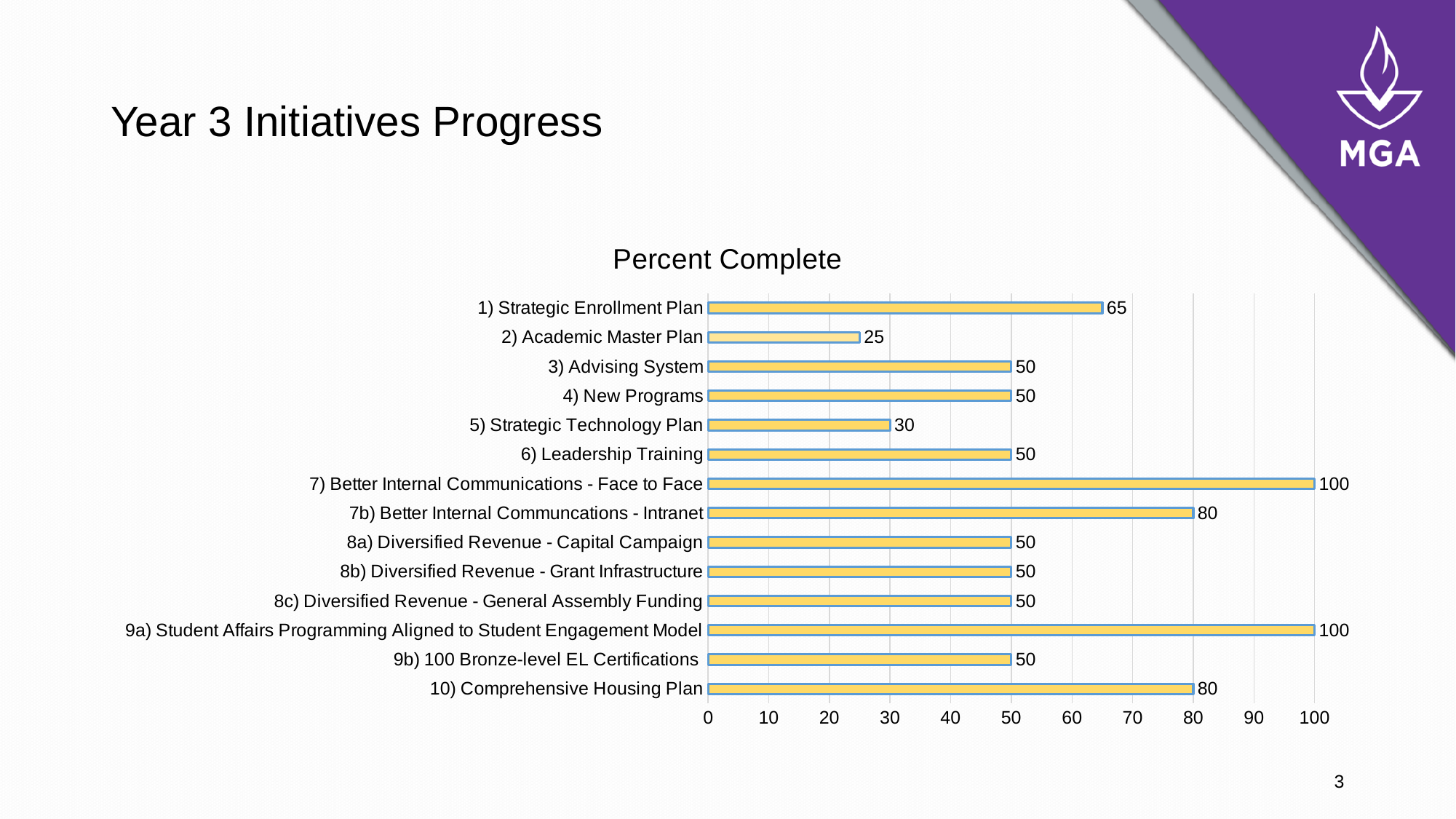
What is the title of the chart? Percent Complete What is the percent complete for 5) Strategic Technology Plan? 30 Which initiative has the lowest percent complete? 2) Academic Master Plan What is the percent complete for 1) Strategic Enrollment Plan? 65 What kind of chart is shown on the slide? Bar chart What is the difference in percent complete between 7b) Better Internal Communcations - Intranet and 2) Academic Master Plan? 55 Which has a higher percent complete, 1) Strategic Enrollment Plan or 5) Strategic Technology Plan? 1) Strategic Enrollment Plan How many initiatives are shown in the chart? 14 What is the difference in percent complete between 7) Better Internal Communications - Face to Face and 1) Strategic Enrollment Plan? 35 What is the percent complete for 2) Academic Master Plan? 25 What is the percent complete for 10) Comprehensive Housing Plan? 80 How many initiatives have a percent complete of 100? 2